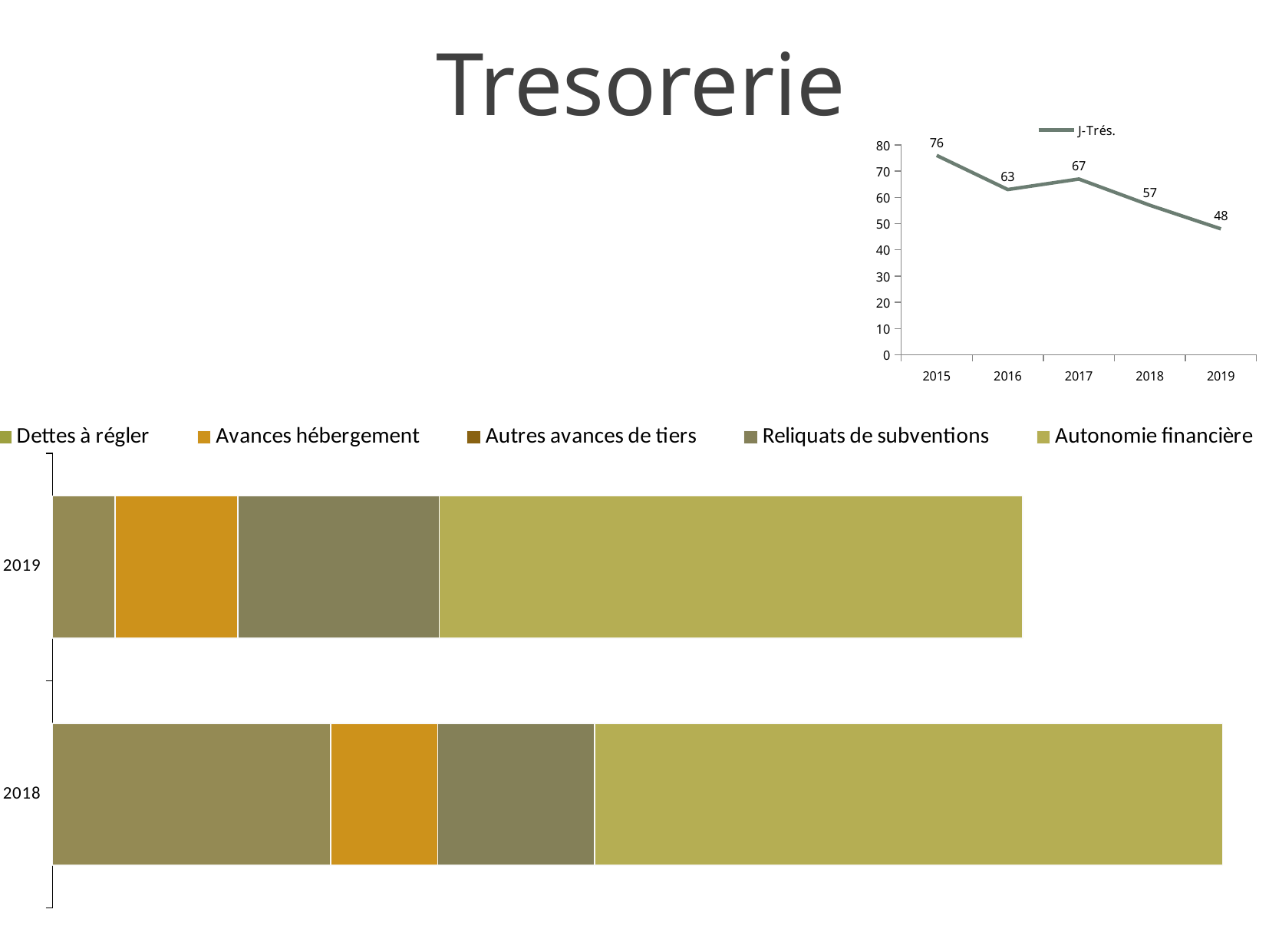
In the line chart at the top right, do the values generally rise or fall from 2015 to 2019? fall What kind of chart is the chart at the bottom of the slide? stacked bar chart In the line chart at the top right, what is the difference between the values for 2015 and 2019? 28 In the line chart at the top right, what is the name of the series shown in the legend? J-Trés. In the line chart at the top right, what is the value for 2017? 67 In the line chart at the top right, which is larger, the value for 2016 or the value for 2017? 2017 In the line chart at the top right, what is the value for 2019? 48 In the line chart at the top right, which year has the highest value? 2015 In the line chart at the top right, which year has the lowest value? 2019 In the bottom chart, which year has the longer total bar, 2018 or 2019? 2018 In the line chart at the top right, what is the value for 2015? 76 How many series does the legend of the bottom chart list? 5